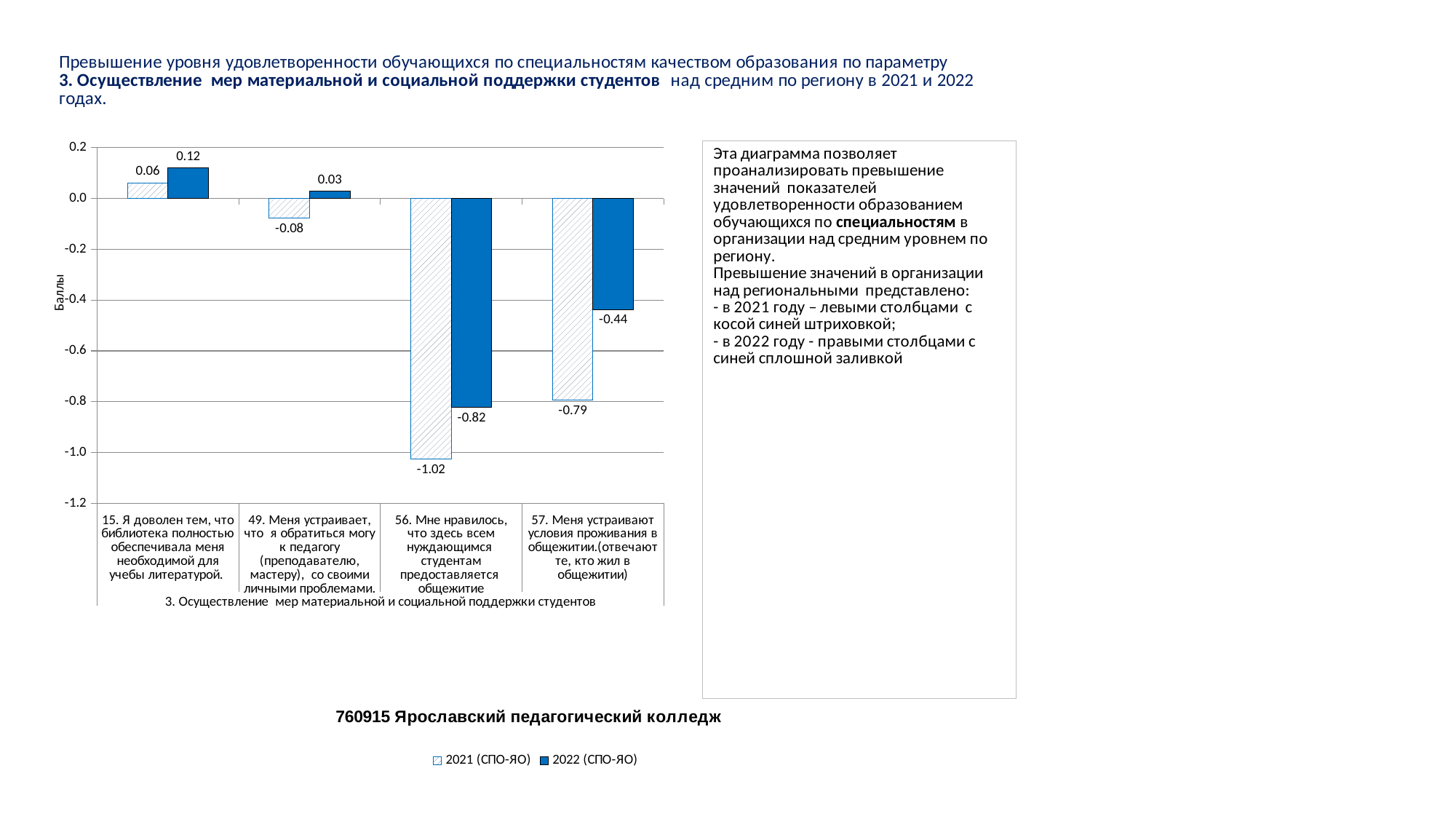
What is the difference between the 2022 and 2021 values for category 57 (Меня устраивают условия проживания в общежитии)? 0.35 What is the 2022 (СПО-ЯО) value for category 57 (Меня устраивают условия проживания в общежитии)? -0.44 What type of chart is shown on the slide? bar chart What is the 2021 (СПО-ЯО) value for category 49 (Меня устраивает, что я обратиться могу к педагогу со своими личными проблемами)? -0.08 For category 56, which series has the larger value: 2021 (СПО-ЯО) or 2022 (СПО-ЯО)? 2022 (СПО-ЯО) What is the 2021 (СПО-ЯО) value for category 56 (Мне нравилось, что здесь всем нуждающимся студентам предоставляется общежитие)? -1.02 What is the 2022 (СПО-ЯО) value for category 15 (Я доволен тем, что библиотека полностью обеспечивала меня необходимой для учебы литературой)? 0.12 What is the label of the vertical axis of the chart? Баллы Which category has the lowest 2021 (СПО-ЯО) value? 56. Мне нравилось, что здесь всем нуждающимся студентам предоставляется общежитие How many categories (questions) are shown on the x axis of the chart? 4 How many series does the chart legend list? 2 Which category has the highest 2022 (СПО-ЯО) value? 15. Я доволен тем, что библиотека полностью обеспечивала меня необходимой для учебы литературой.